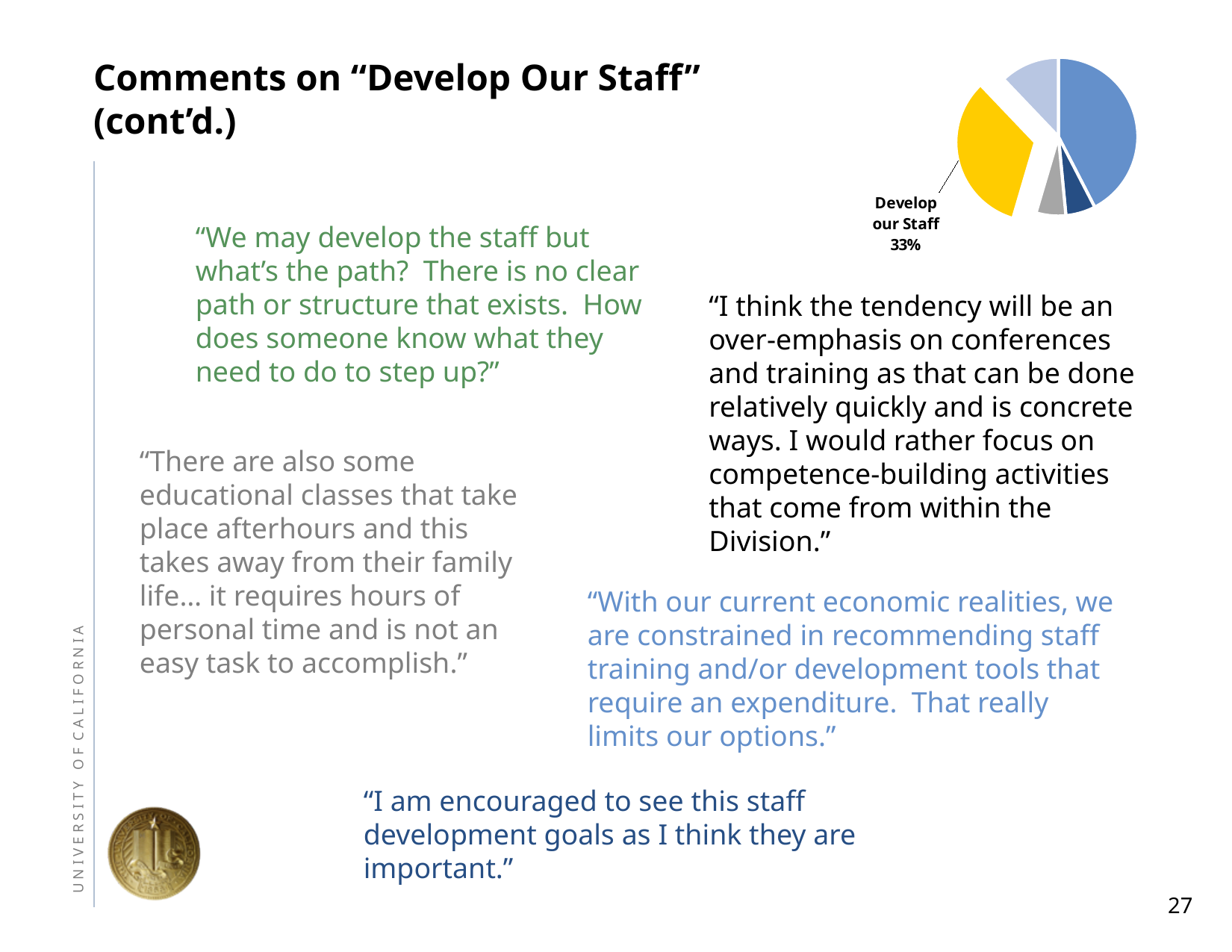
What kind of chart is shown in the top-right corner of the slide? pie chart What percentage does the "Develop our Staff" slice represent in the pie chart? 33% What colour is the "Develop our Staff" slice in the pie chart? yellow Which slice of the pie chart is labeled on the slide? Develop our Staff In the pie chart, is the "Develop our Staff" slice larger or smaller than the dark navy slice? larger What is the share of the pie taken by the "Develop our Staff" slice? 33% In the pie chart, is the "Develop our Staff" slice larger or smaller than the gray slice? larger